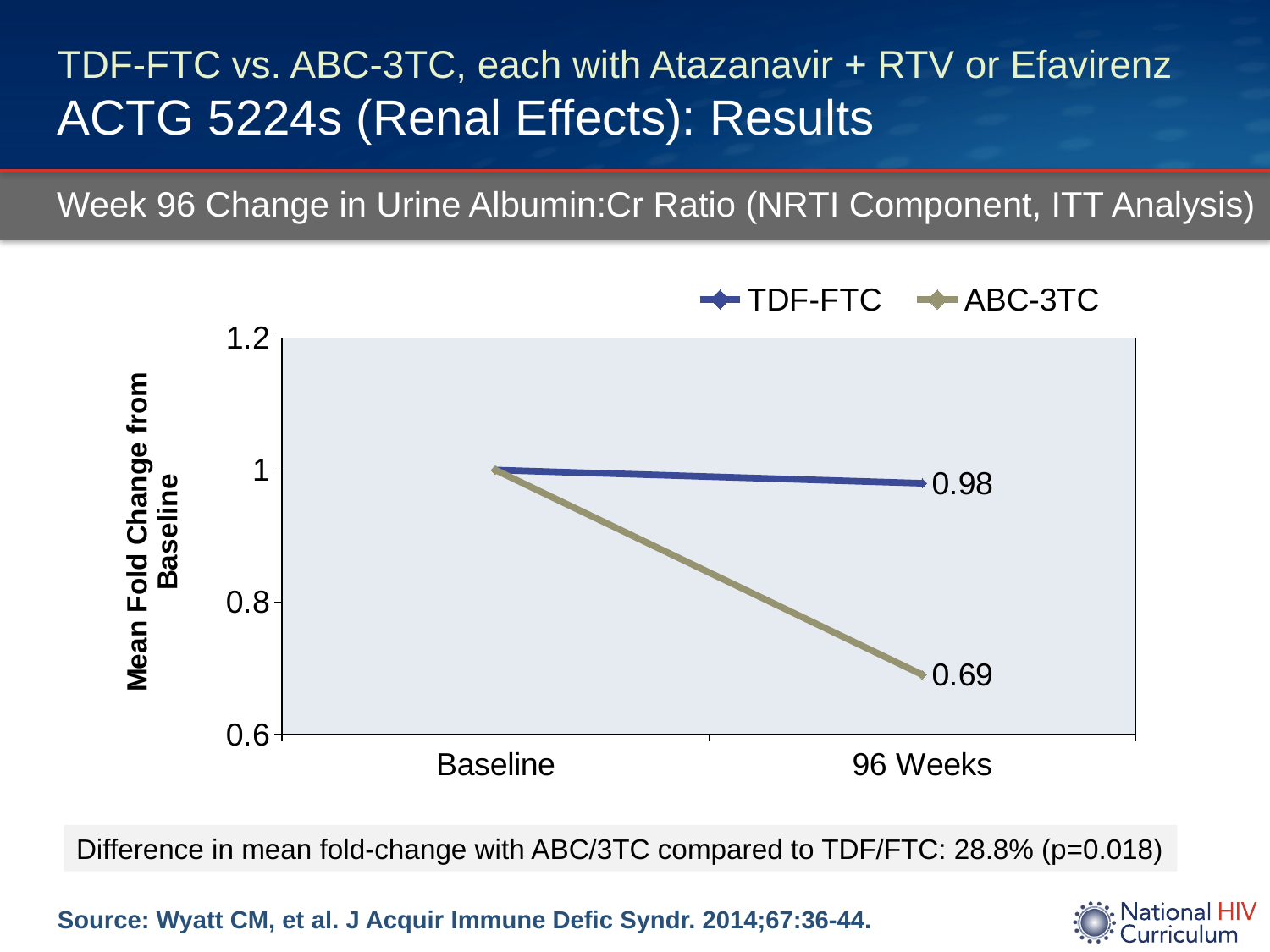
Is the value for ABC-3TC at 96 weeks greater or less than 0.8? less What is the mean fold change from baseline for TDF-FTC at 96 weeks? 0.98 How many time points are shown on the x axis? 2 What kind of chart is shown on the slide? Line chart Which series has the higher mean fold change at 96 weeks, TDF-FTC or ABC-3TC? TDF-FTC What is the mean fold change from baseline for ABC-3TC at 96 weeks? 0.69 What are the two series named in the legend? TDF-FTC and ABC-3TC What is the difference between the TDF-FTC and ABC-3TC mean fold change values at 96 weeks? 0.29 What is the title of the y axis? Mean Fold Change from Baseline Does the ABC-3TC line rise or fall from Baseline to 96 Weeks? Fall How many series does the legend list? 2 Does the TDF-FTC line rise or fall from Baseline to 96 Weeks? Fall